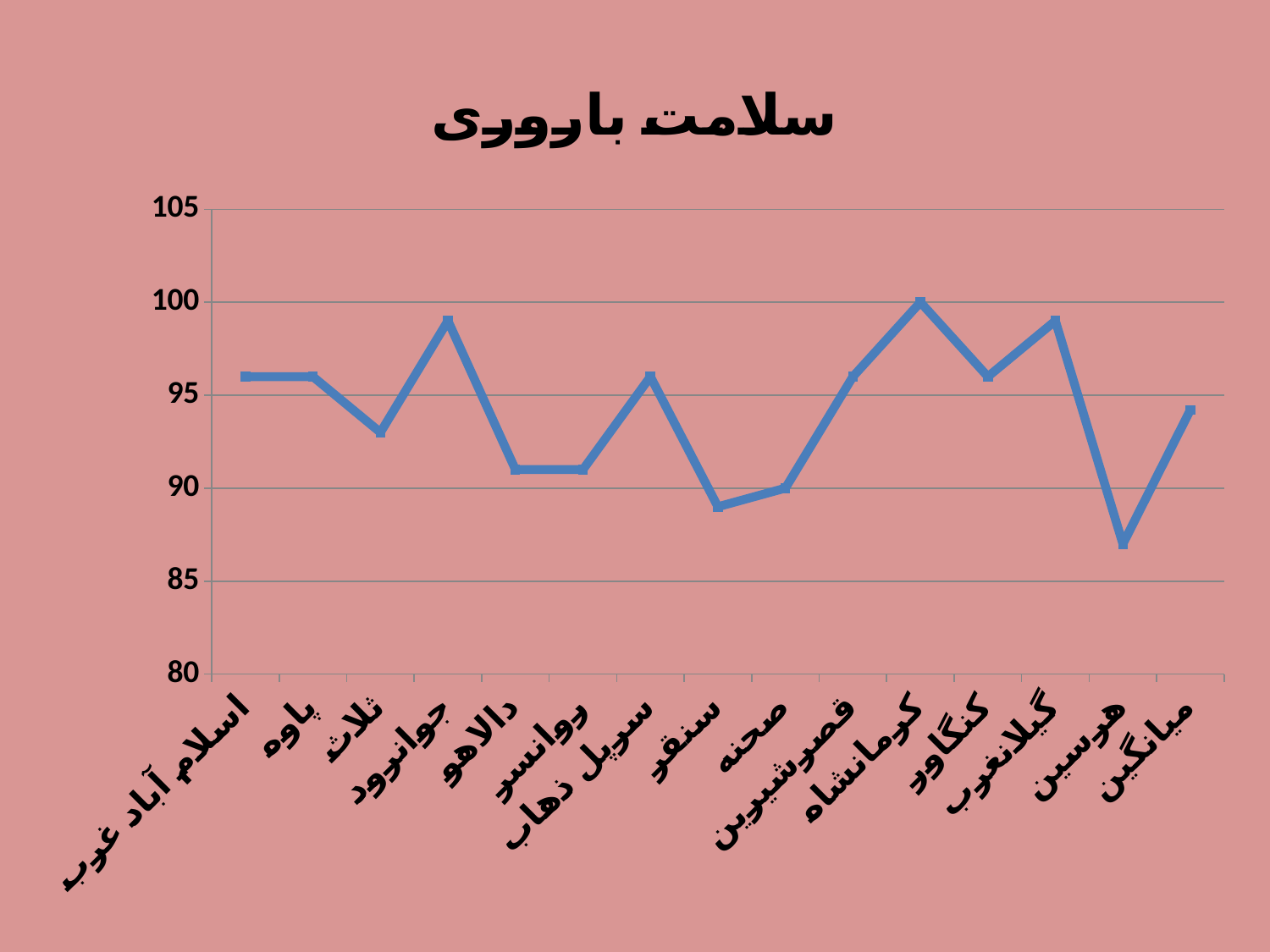
What is the value for کرمانشاه? 100 Does the line rise or fall from گیلانغرب to هرسین? fall Which category has the highest value? کرمانشاه Which is larger, the value for جوانرود or the value for دالاهو? جوانرود Is the value for جوانرود greater or less than 95? greater What is the title of the chart? سلامت باروری What is the value for صحنه? 90 What kind of chart is shown on the slide? line chart Is the value for هرسین greater or less than 90? less Is the value for ثلاث greater or less than 95? less Which category has the lowest value? هرسین How many categories are plotted along the x axis? 15